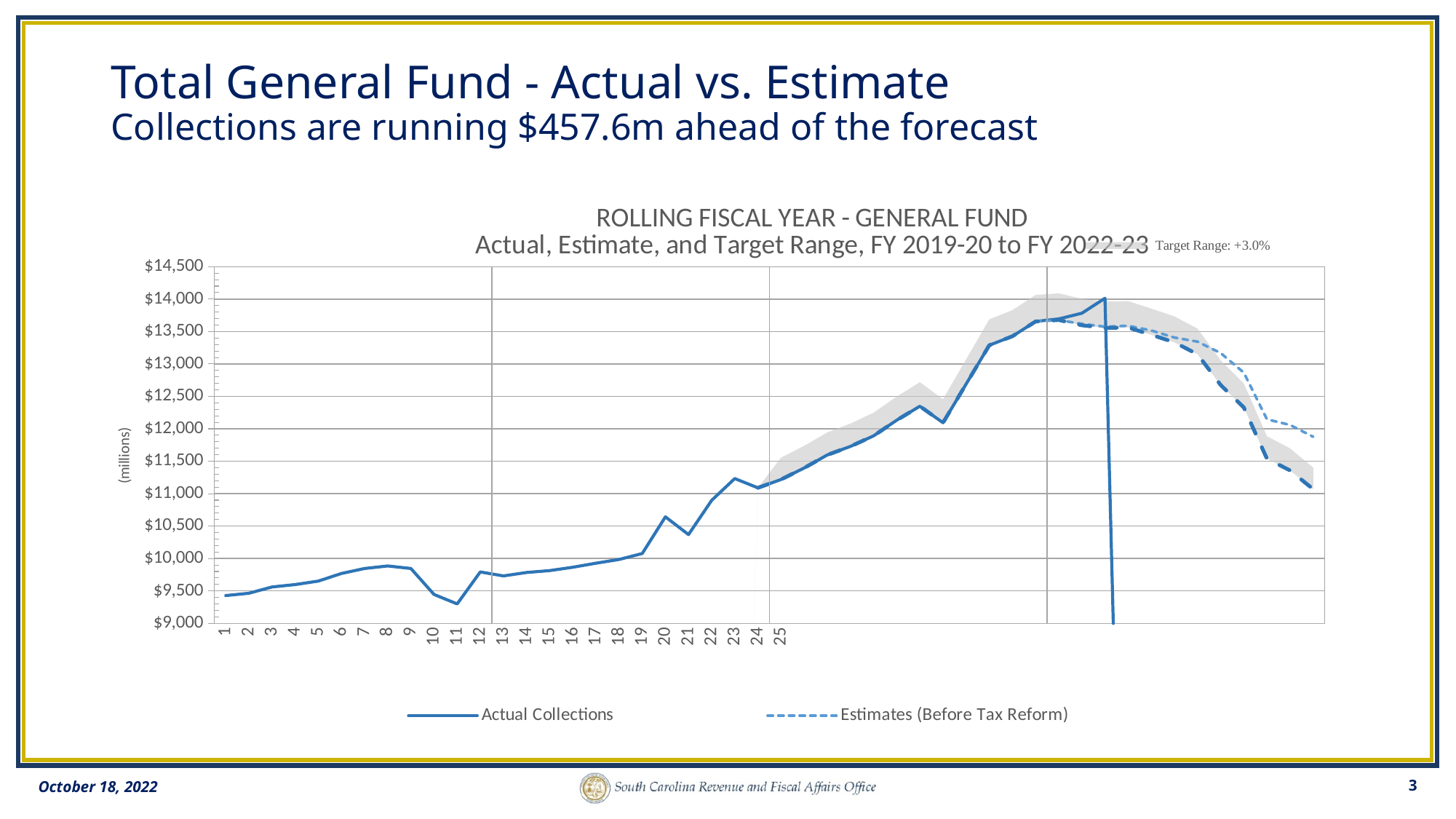
How many numbered points are labeled on the x axis? 25 Is the Actual Collections value at point 20 greater or less than $10,500? greater Which is larger for Actual Collections: the value at point 20 or at point 21? point 20 What target range is stated next to the chart title? +3.0% Is the Actual Collections value at point 8 greater or less than $10,000? less Is the Actual Collections value at point 23 greater or less than $11,000? greater What kind of chart is shown on the slide? line chart What are the two series named in the legend? Actual Collections; Estimates (Before Tax Reform) How many series does the legend list? 2 Do Actual Collections generally rise or fall from point 12 to point 19? rise